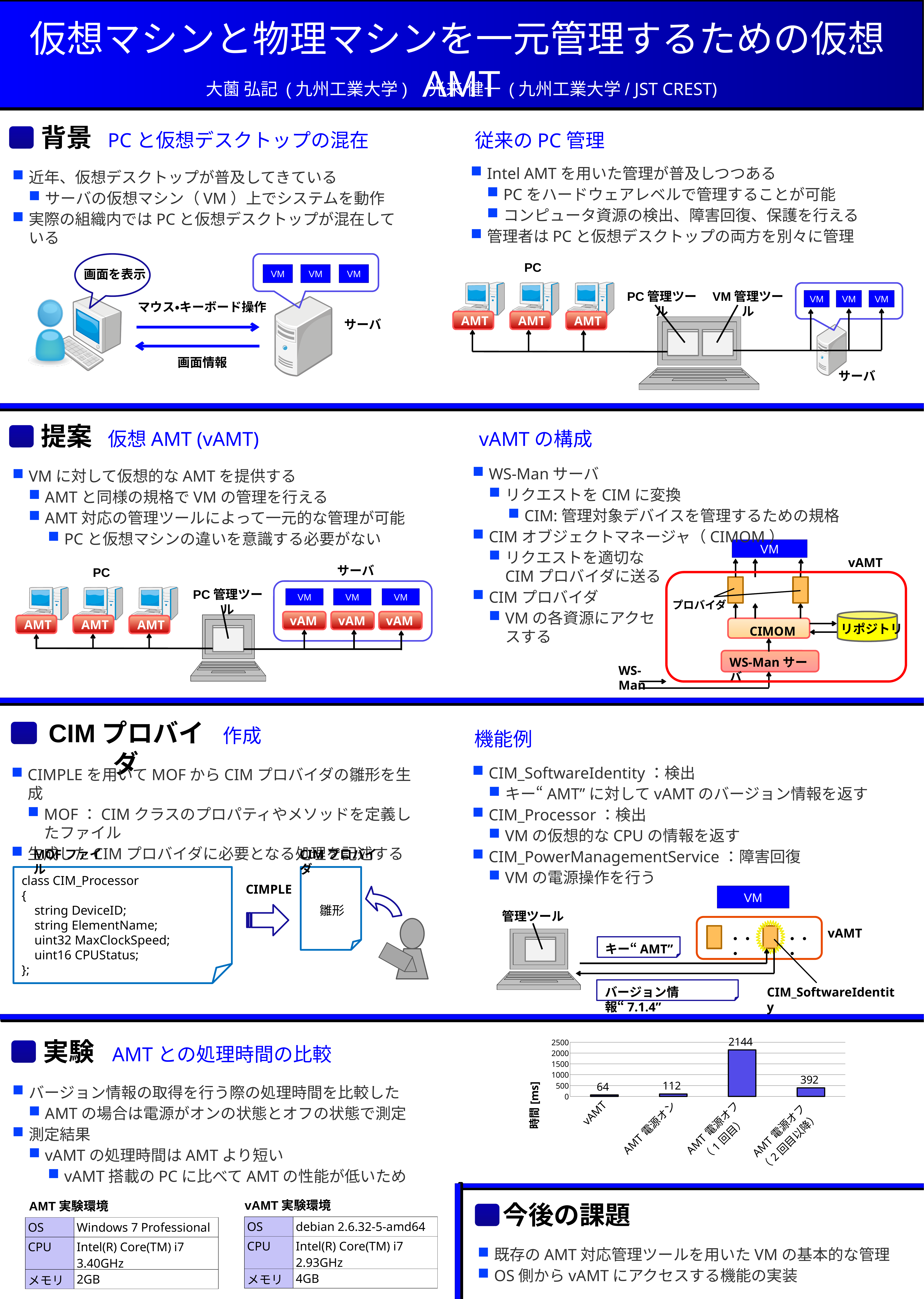
Is the value for AMT 電源オフ（1回目） greater or less than 2000? greater What is the difference between the values for AMT 電源オン and vAMT? 48 What is the value for AMT 電源オフ（2回目以降） in the bar chart? 392 What is the value for AMT 電源オン in the bar chart? 112 What is the label of the vertical axis of the bar chart? 時間 [ms] Which category has the highest value in the bar chart? AMT 電源オフ（1回目） What is the value for AMT 電源オフ（1回目） in the bar chart? 2144 What is the difference between the values for AMT 電源オフ（1回目） and AMT 電源オフ（2回目以降）? 1752 Which category has the lowest value in the bar chart? vAMT Which is larger, the value for AMT 電源オフ（2回目以降） or the value for AMT 電源オン? AMT 電源オフ（2回目以降） What is the value for vAMT in the bar chart? 64 How many categories are shown in the bar chart? 4